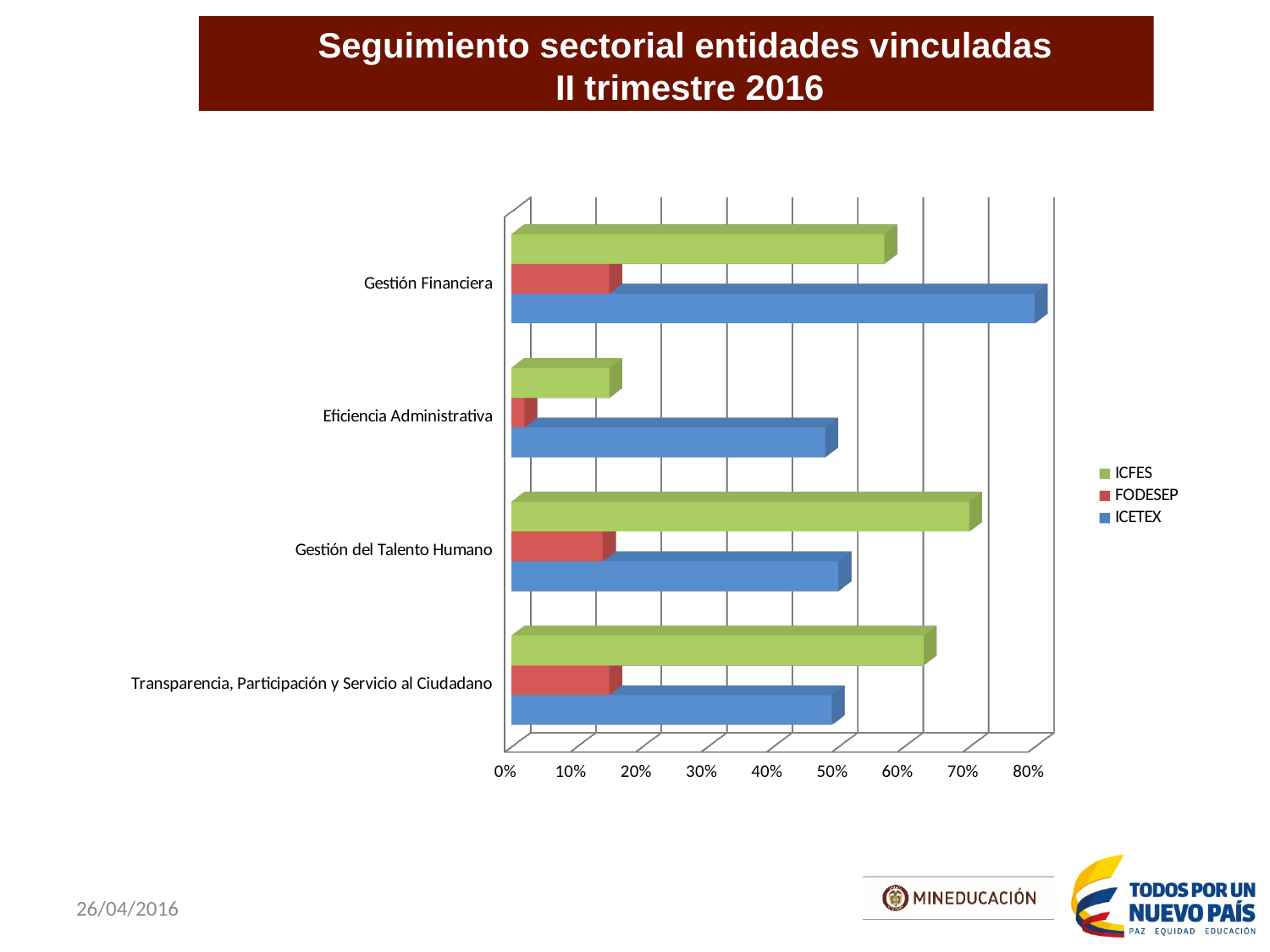
For which category is the FODESEP value lowest? Eficiencia Administrativa Is the ICFES value for Gestión del Talento Humano greater or less than 60%? greater Is the FODESEP value for Eficiencia Administrativa greater or less than 10%? less Is the ICFES value for Eficiencia Administrativa greater or less than 30%? less How many series does the legend list? 3 Which entity does the green series represent? ICFES How many categories are shown on the chart? 4 What kind of chart is shown on the slide? bar chart For which category is the ICETEX value highest? Gestión Financiera For Gestión Financiera, which is larger: the ICFES value or the ICETEX value? ICETEX For which category is the ICFES value highest? Gestión del Talento Humano